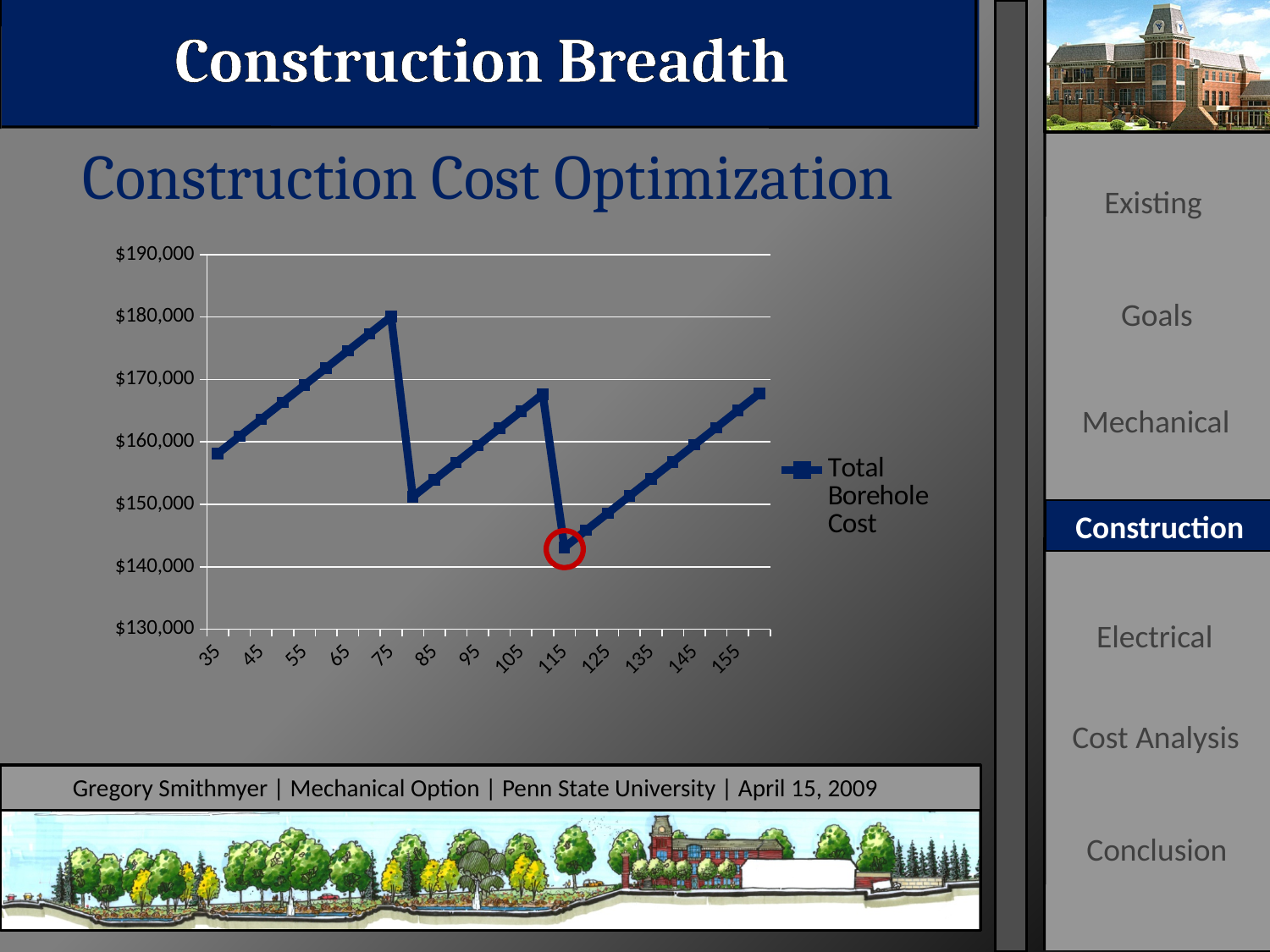
Is the Total Borehole Cost at x = 155 greater or less than $160,000? greater Is the Total Borehole Cost at x = 115 greater or less than $150,000? less What is the Total Borehole Cost at x = 75? $180,000 At which x-axis value does the Total Borehole Cost reach its highest point? 75 At which x-axis value does the Total Borehole Cost reach its lowest point (the circled point)? 115 How many series does the legend list? 1 Is the Total Borehole Cost at x = 35 greater or less than $150,000? greater What kind of chart is shown on the slide? Line chart What is the name of the series shown in the legend? Total Borehole Cost Does the Total Borehole Cost rise or fall between x = 35 and x = 75? rise Which has the higher Total Borehole Cost, x = 75 or x = 155? 75